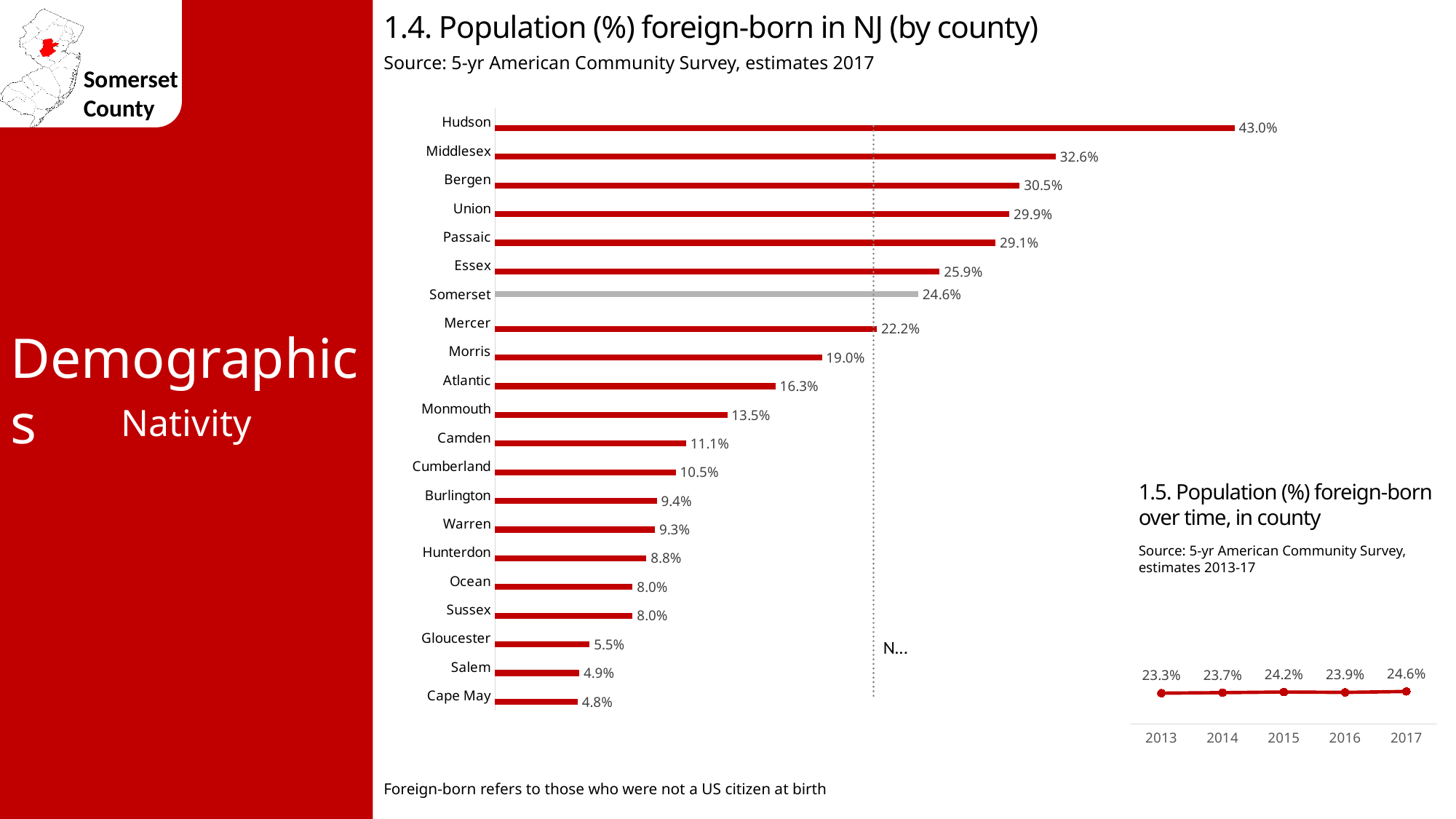
What kind of chart is '1.4. Population (%) foreign-born in NJ (by county)'? Bar chart In the chart '1.4. Population (%) foreign-born in NJ (by county)', which county has the lowest value? Cape May In the chart '1.4. Population (%) foreign-born in NJ (by county)', which is larger, Bergen or Union? Bergen In the chart '1.5. Population (%) foreign-born over time, in county', what is the difference between 2017 and 2013? 1.3% In the chart '1.4. Population (%) foreign-born in NJ (by county)', what is the value for Somerset? 24.6% In the chart '1.5. Population (%) foreign-born over time, in county', which year has the lowest value? 2013 In the chart '1.4. Population (%) foreign-born in NJ (by county)', which county has the highest value? Hudson In the chart '1.5. Population (%) foreign-born over time, in county', what is the value for 2015? 24.2% In the chart '1.4. Population (%) foreign-born in NJ (by county)', which county's bar is shown in grey instead of red? Somerset In the chart '1.4. Population (%) foreign-born in NJ (by county)', how many counties are shown? 21 In the chart '1.4. Population (%) foreign-born in NJ (by county)', what is the value for Mercer? 22.2% In the chart '1.4. Population (%) foreign-born in NJ (by county)', what is the difference between Hudson and Middlesex? 10.4%